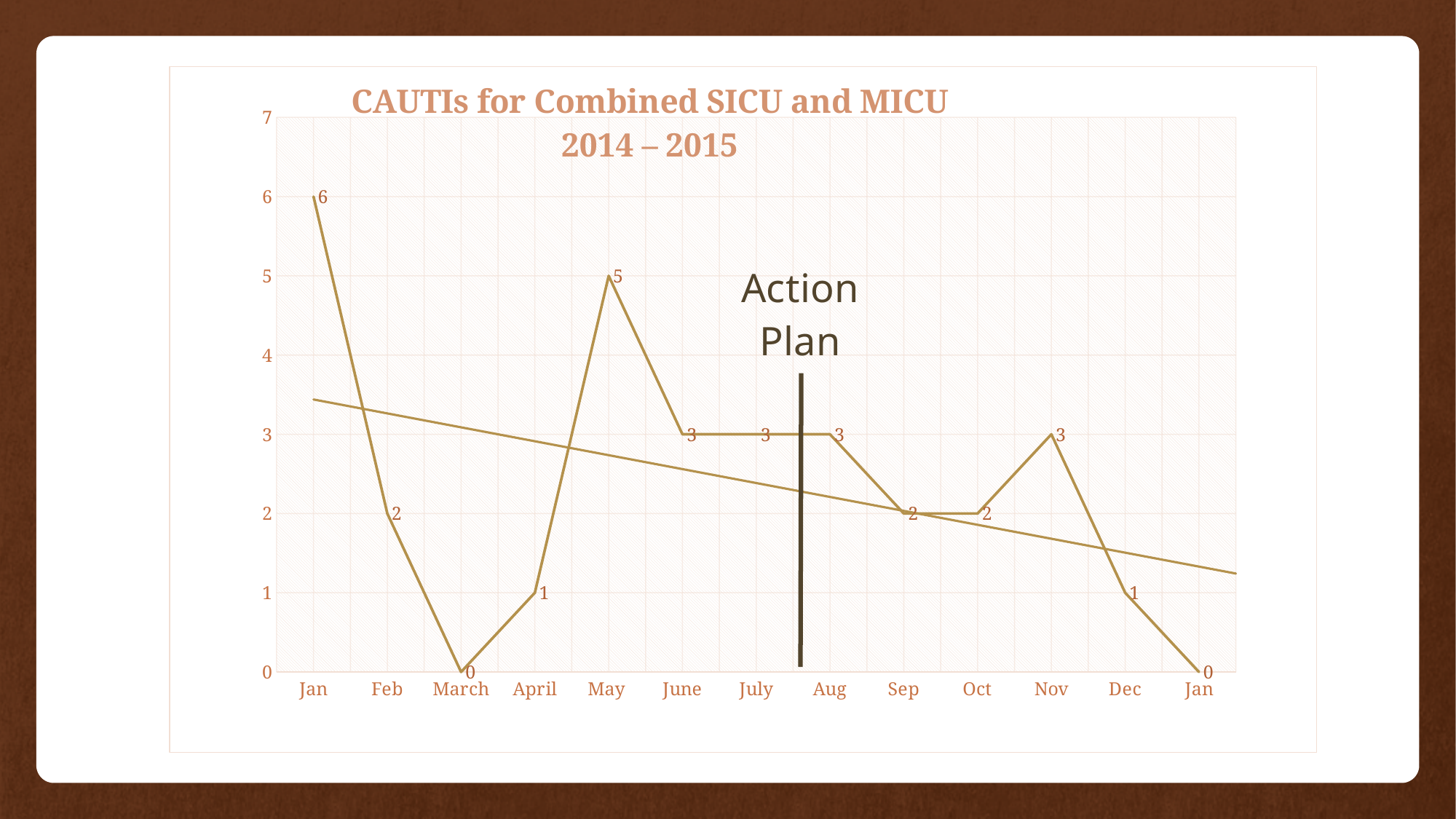
What is the value for Sep? 2 Which is larger, the value for Nov or the value for Dec? Nov What is the difference between the values for May and June? 2 What is the title of the chart? CAUTIs for Combined SICU and MICU 2014 – 2015 How many data points are plotted on the line? 13 What is the value for Dec? 1 What kind of chart is this? Line chart Which month has the highest value? Jan (the first one) What is the value for May? 5 What is the lowest value plotted on the chart? 0 What is the difference between the first Jan value and the Feb value? 4 What is the value for the first Jan on the x axis? 6